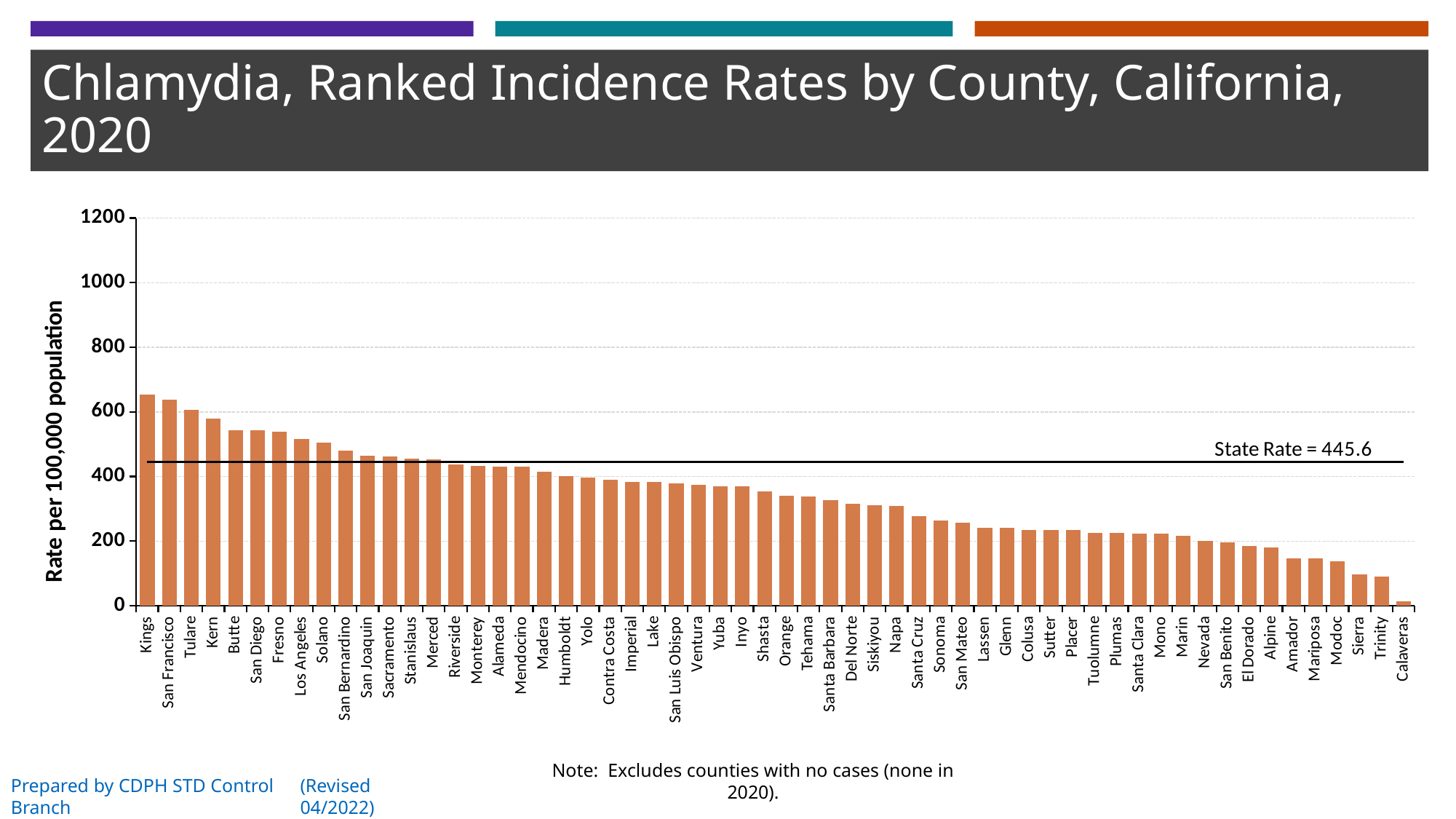
What kind of chart is shown on the slide? bar chart Which has a higher rate, Tulare or Santa Clara? Tulare Which county has the lowest chlamydia incidence rate? Calaveras Which county has the highest chlamydia incidence rate? Kings How many counties are plotted on the chart? 58 Is the value for Sierra greater or less than 200? less Is the value for Kings greater or less than 600? greater What is the label of the y axis? Rate per 100,000 population Is the value for Butte greater or less than 400? greater Do the bar values rise or fall from left to right along the x axis? fall What is the State Rate shown on the chart? 445.6